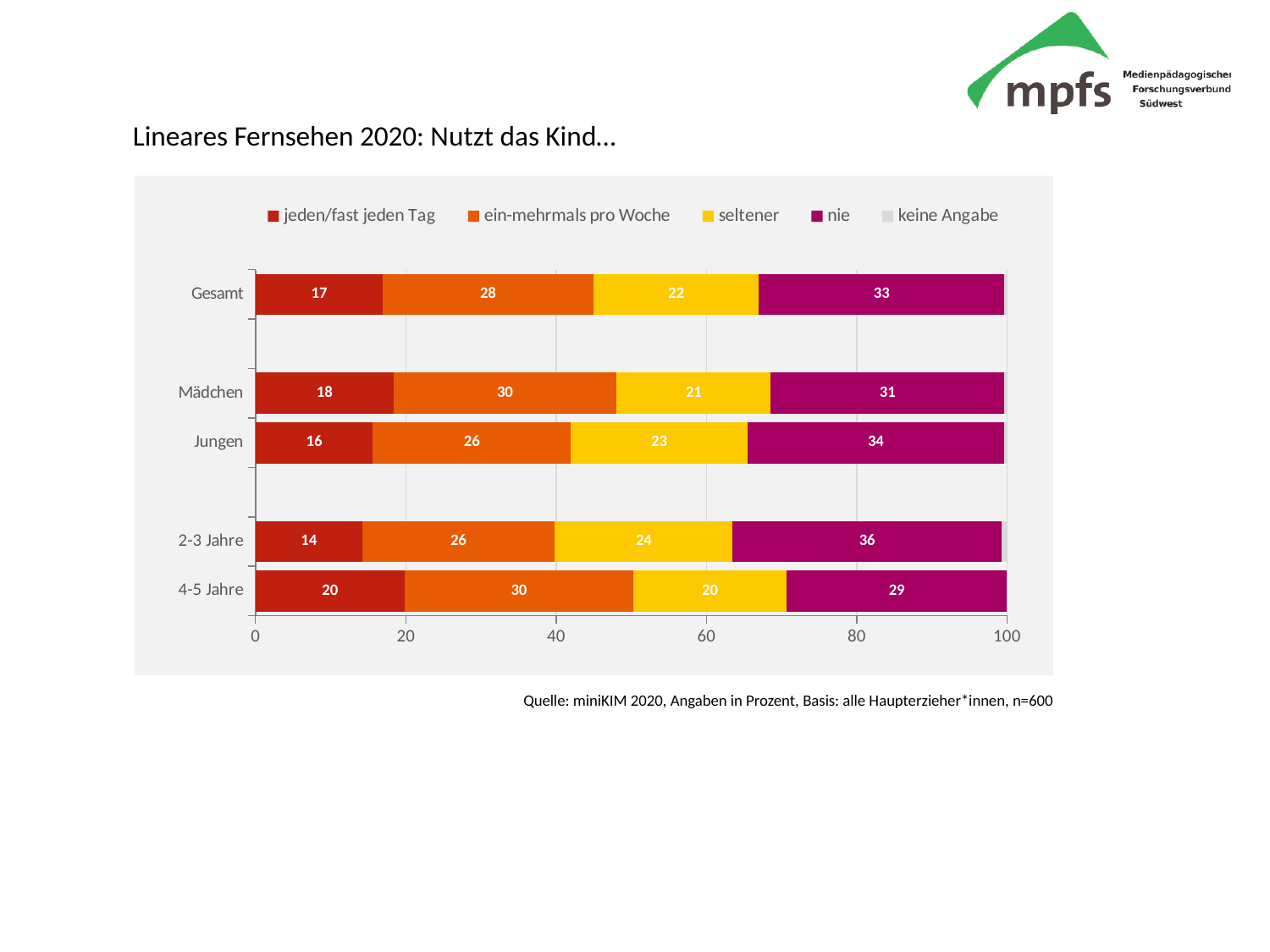
What kind of chart is shown on the slide? stacked bar chart Which category has the lowest value for 'jeden/fast jeden Tag'? 2-3 Jahre What is the value for 'nie' in the Gesamt bar? 33 What is the value for 'jeden/fast jeden Tag' for 4-5 Jahre? 20 What is the title of the chart? Lineares Fernsehen 2020: Nutzt das Kind… What is the value for 'ein-mehrmals pro Woche' for Mädchen? 30 What is the value for 'seltener' for Jungen? 23 What is the difference between the 'nie' values for 2-3 Jahre and 4-5 Jahre? 7 How many series does the legend list? 5 Which category has the highest value for 'nie'? 2-3 Jahre How many categories are shown on the vertical axis? 5 Which is larger: the 'ein-mehrmals pro Woche' value for Mädchen or for Jungen? Mädchen